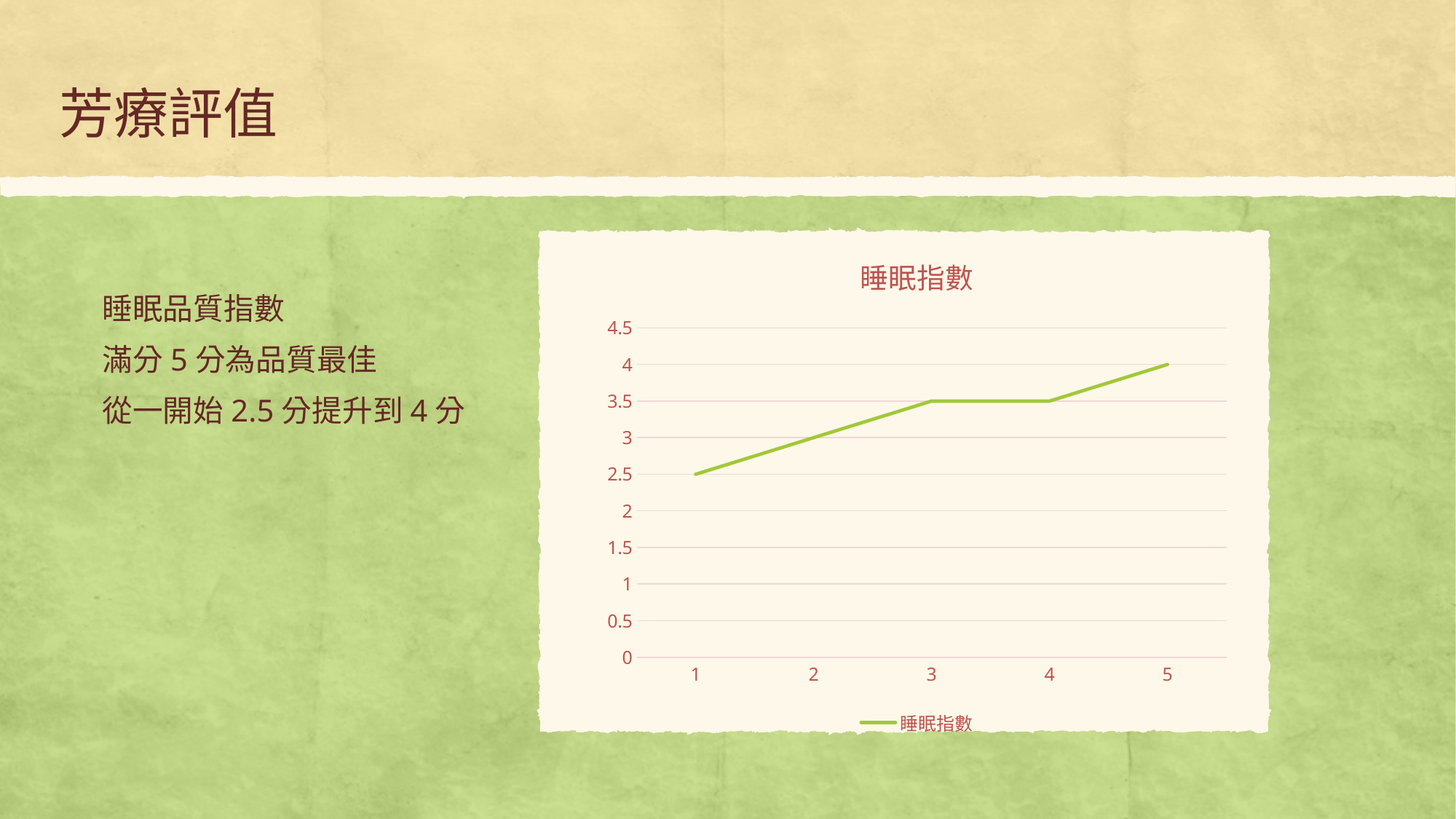
What is the title of the chart? 睡眠指數 How many series does the legend list? 1 Do the 睡眠指數 values rise or fall from x = 1 to x = 5? rise At which x value is 睡眠指數 highest? 5 What is the value of 睡眠指數 at x = 3? 3.5 What kind of chart is shown on the slide? line chart What is the difference between the 睡眠指數 value at x = 5 and at x = 1? 1.5 Which is larger, the 睡眠指數 value at x = 4 or at x = 5? x = 5 At which x value is 睡眠指數 lowest? 1 What is the value of 睡眠指數 at x = 1? 2.5 What is the value of 睡眠指數 at x = 5? 4 How many points are plotted along the x axis? 5